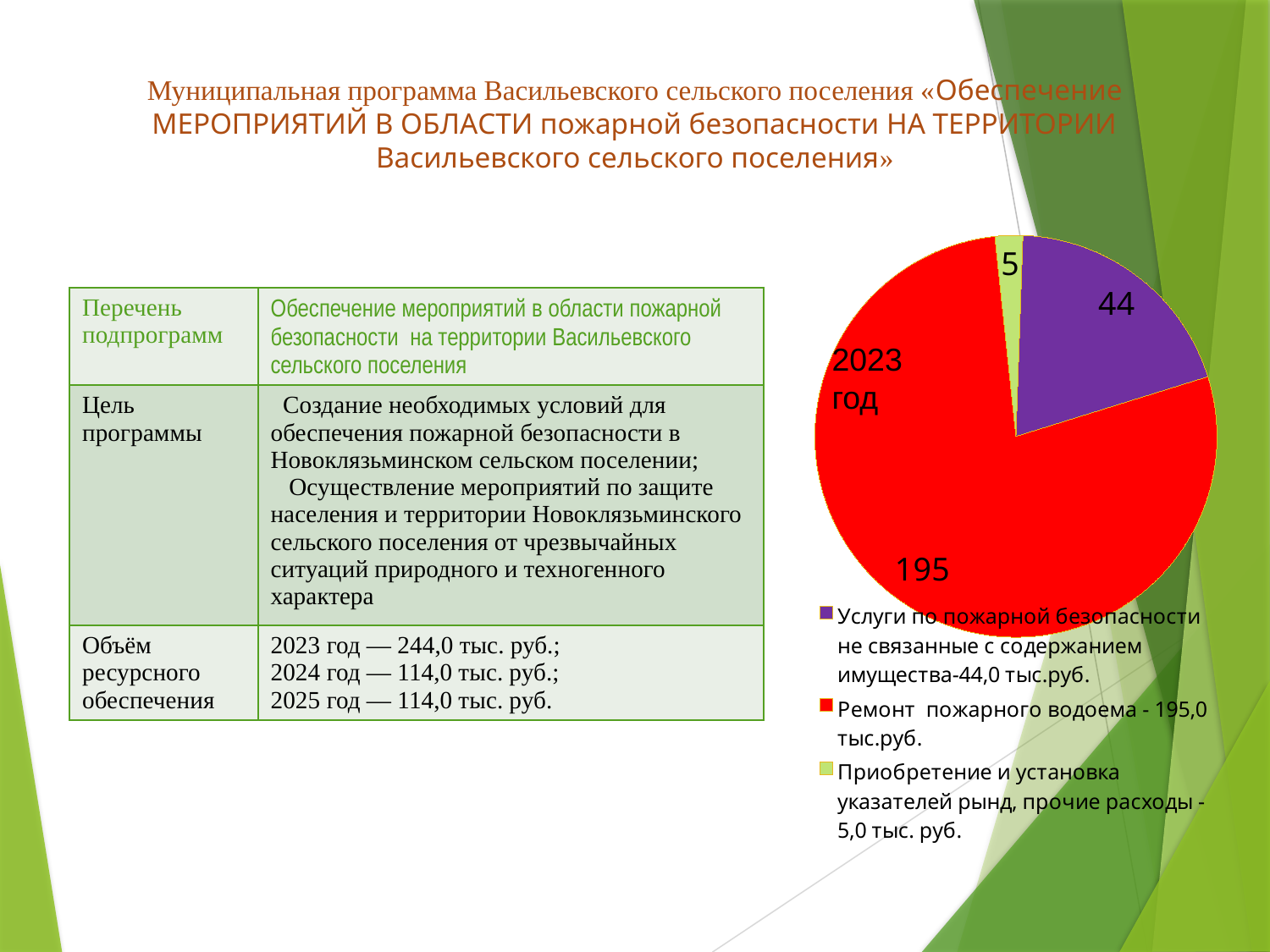
Which is larger in the pie chart: the value for "Услуги по пожарной безопасности не связанные с содержанием имущества" or the value for "Приобретение и установка указателей рынд, прочие расходы"? Услуги по пожарной безопасности не связанные с содержанием имущества Which slice of the pie chart is the smallest? Приобретение и установка указателей рынд, прочие расходы What kind of chart is shown on the slide? pie chart What value is shown for the slice "Приобретение и установка указателей рынд, прочие расходы" in the pie chart? 5 Which slice of the pie chart is the largest? Ремонт пожарного водоема What is the total of all slices in the pie chart? 244 How many slices does the pie chart have? 3 How many entries does the legend of the pie chart list? 3 What value is shown for the slice "Услуги по пожарной безопасности не связанные с содержанием имущества" in the pie chart? 44 What colour is the slice for "Ремонт пожарного водоема" in the pie chart? red What is the difference between the value for "Ремонт пожарного водоема" and the value for "Услуги по пожарной безопасности не связанные с содержанием имущества" in the pie chart? 151 What value is shown for the slice "Ремонт пожарного водоема" in the pie chart? 195